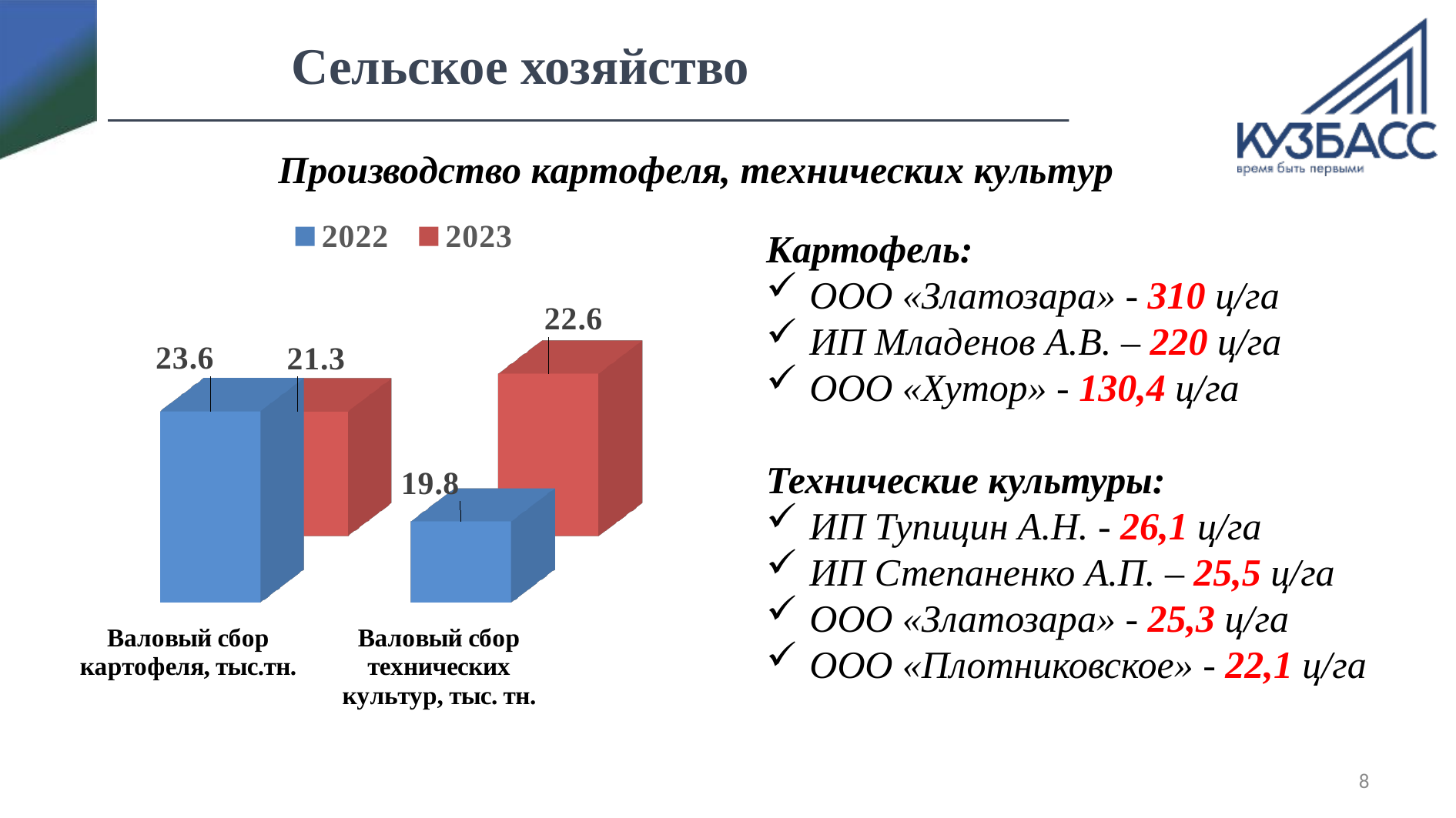
What type of chart is shown on the slide? Bar chart What was the gross harvest of technical crops (Валовый сбор технических культур, тыс. тн.) in 2023? 22.6 Which year had the larger gross potato harvest, 2022 or 2023? 2022 By how much did the gross potato harvest change from 2022 to 2023? 2.3 Which bar in the chart has the highest value? Technical crops, 2023 (22.6) How many series does the chart legend list? 2 What was the gross harvest of technical crops (Валовый сбор технических культур, тыс. тн.) in 2022? 19.8 Which bar in the chart has the lowest value? Technical crops, 2022 (19.8) By how much did the gross harvest of technical crops increase from 2022 to 2023? 2.8 What was the gross potato harvest (Валовый сбор картофеля, тыс.тн.) in 2023? 21.3 Which year had the larger gross harvest of technical crops, 2022 or 2023? 2023 What was the gross potato harvest (Валовый сбор картофеля, тыс.тн.) in 2022? 23.6